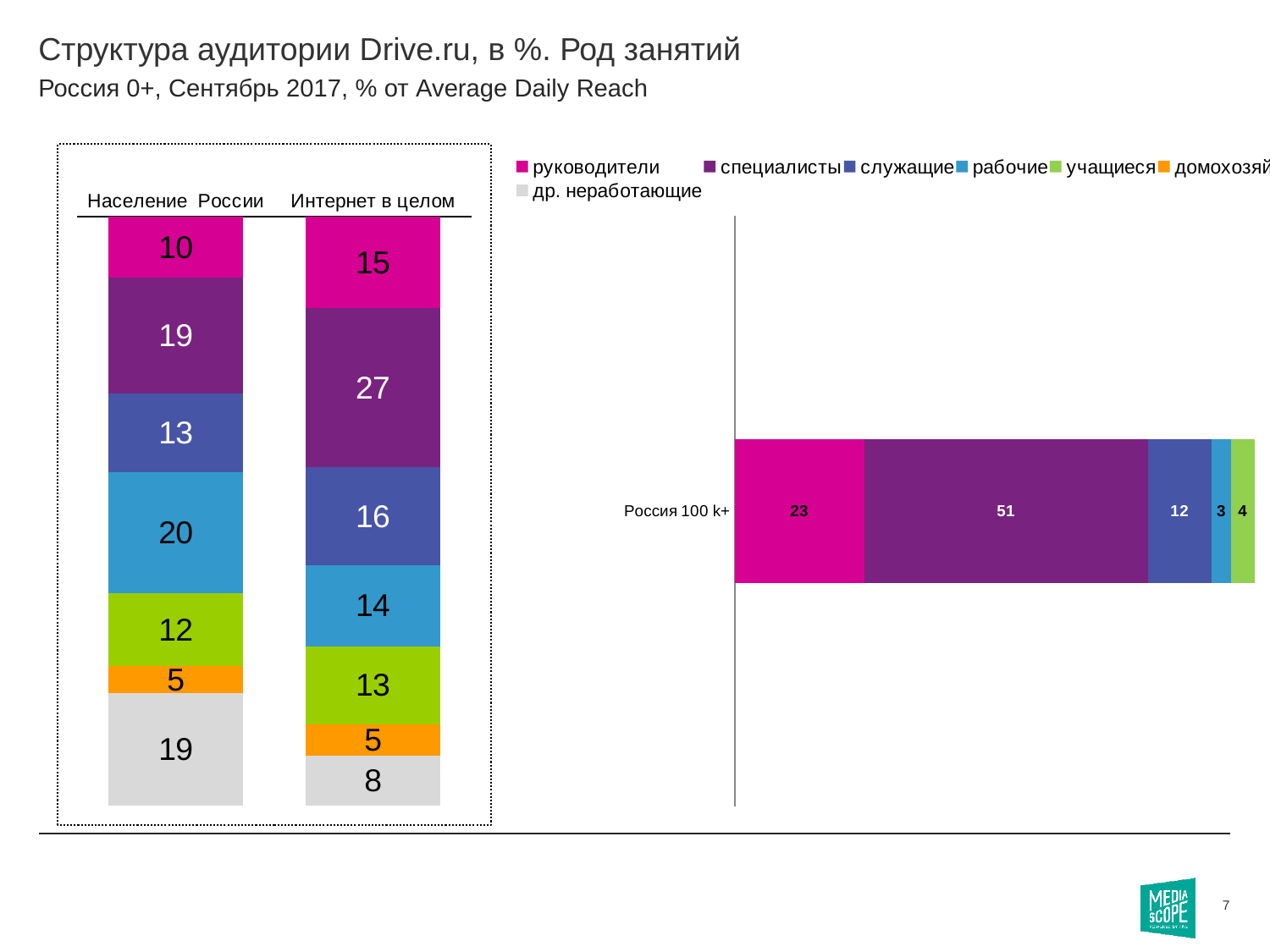
In the left chart, which segment is the largest in the Интернет в целом bar? специалисты In the right chart, what is the value for руководители for Россия 100 k+? 23 In the left chart, which segment is the smallest in the Население России bar? домохозяйки In the left chart, which is larger: др. неработающие for Население России or for Интернет в целом? Население России In the left chart, what is the value for специалисты in the Интернет в целом bar? 27 What type of chart is the right chart? Stacked bar chart How many bars does the left chart show? 2 In the left chart, what is the difference between the руководители values for Интернет в целом and Население России? 5 In the right chart, what is the difference between специалисты and руководители for Россия 100 k+? 28 In the right chart, what is the value for специалисты for Россия 100 k+? 51 In the right chart, what is the value for учащиеся for Россия 100 k+? 4 In the left chart, what is the value for рабочие in the Население России bar? 20